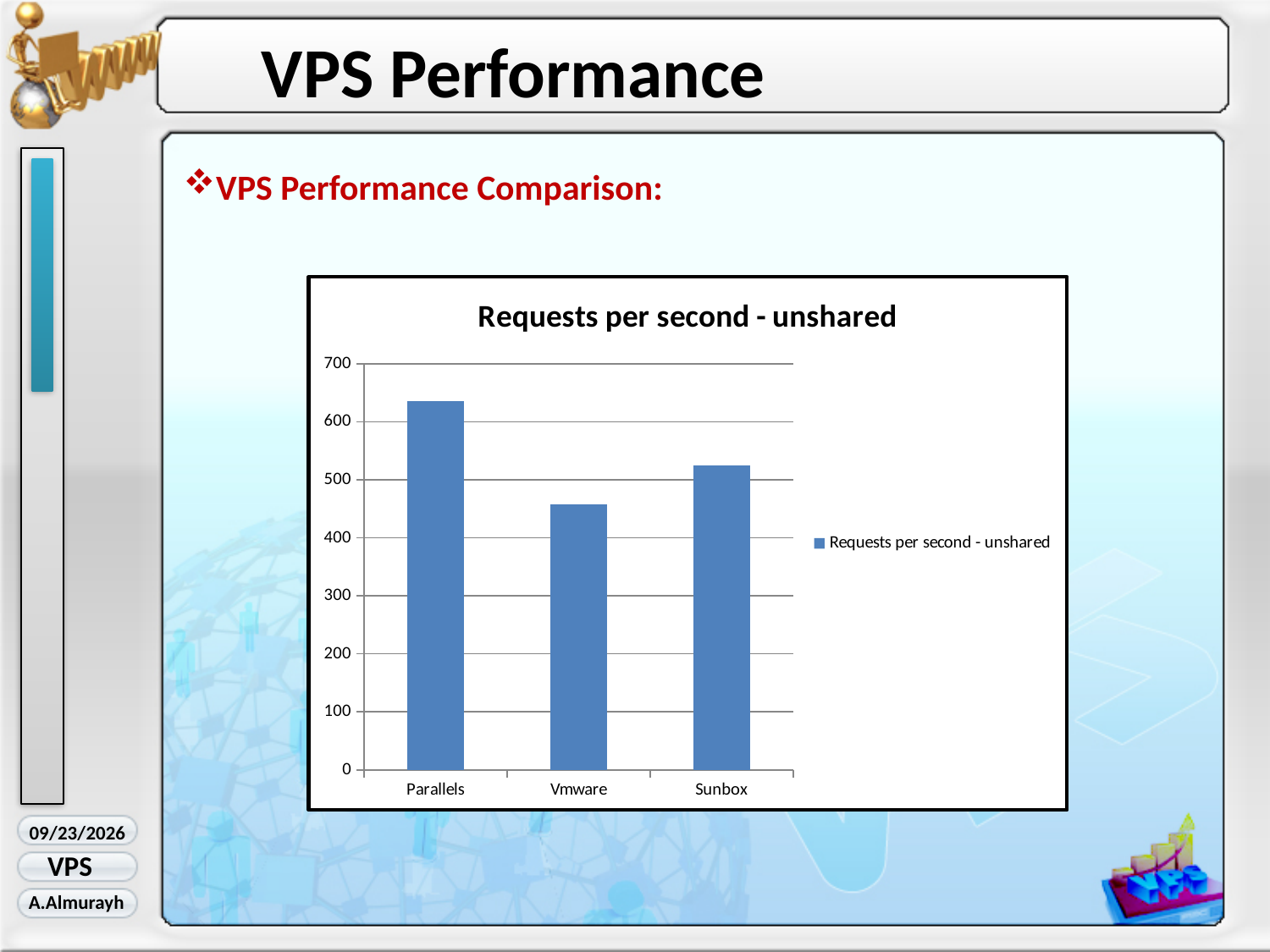
Is the value for Vmware greater or less than 500? less What is the title of the chart? Requests per second - unshared Which has a higher value, Sunbox or Vmware? Sunbox Which has a higher value, Parallels or Sunbox? Parallels Which category has the lowest requests per second? Vmware Is the value for Parallels greater or less than 600? greater How many series does the chart legend list? 1 Is the value for Sunbox greater or less than 500? greater What is the name of the series listed in the chart legend? Requests per second - unshared What kind of chart is shown on the slide? bar chart Which category has the highest requests per second? Parallels How many categories are shown on the x axis of the chart? 3